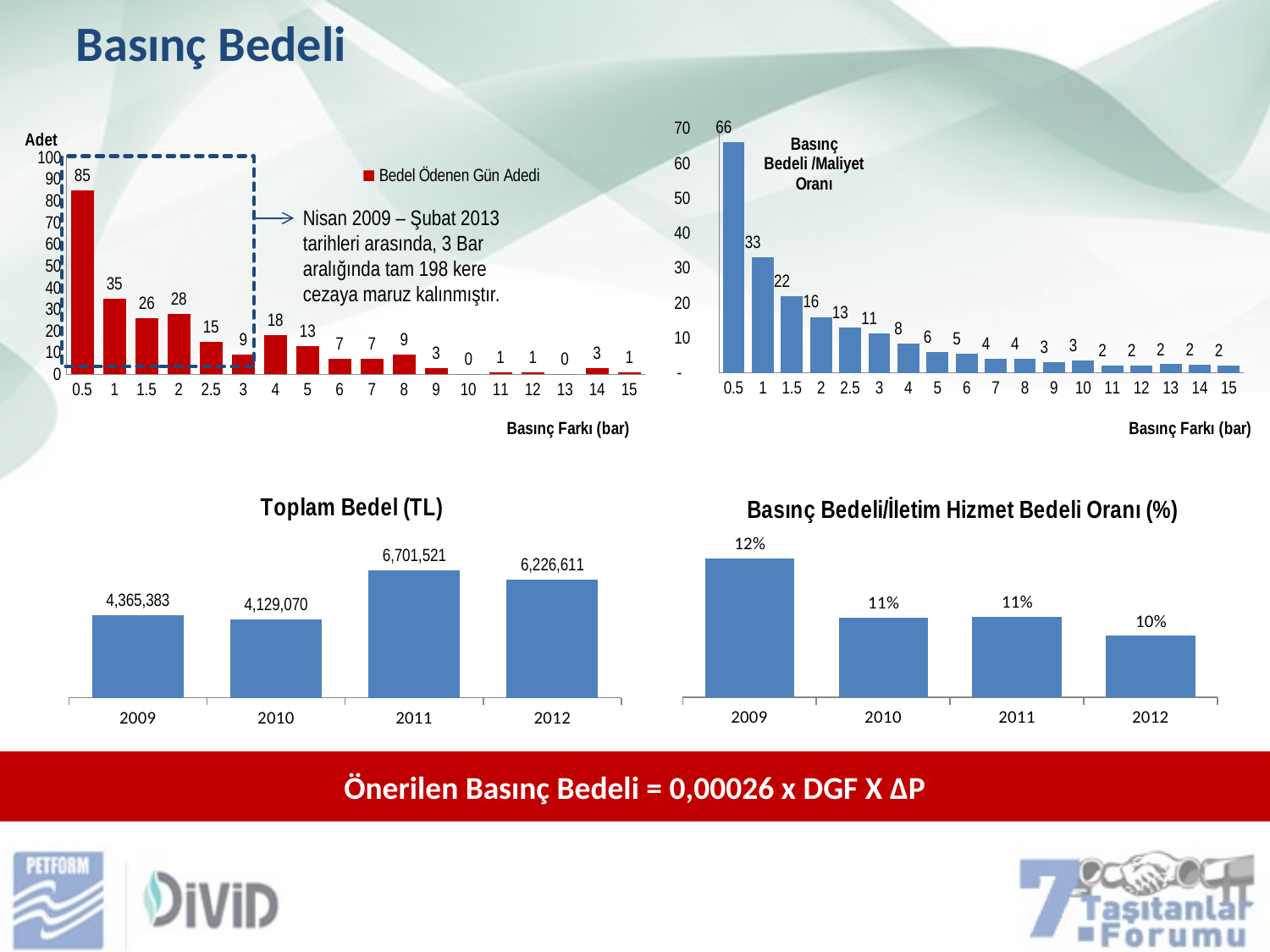
How many categories are shown on the x axis of the top-right 'Basınç Bedeli /Maliyet Oranı' chart? 18 In the top-right 'Basınç Bedeli /Maliyet Oranı' chart, what is the difference between the values at 0.5 bar and 1 bar? 33 In the top-left 'Bedel Ödenen Gün Adedi' chart, which is larger, the value at 1 bar or the value at 2 bar? 1 bar In the top-left 'Bedel Ödenen Gün Adedi' chart, what is the value at 0.5 bar? 85 In the 'Basınç Bedeli/İletim Hizmet Bedeli Oranı (%)' chart, do the values generally rise or fall from 2009 to 2012? fall In the top-left 'Bedel Ödenen Gün Adedi' chart, what is the value at 4 bar? 18 In the 'Toplam Bedel (TL)' chart, what is the difference between the values for 2011 and 2012? 474,910 In the 'Basınç Bedeli/İletim Hizmet Bedeli Oranı (%)' chart, which year has the highest value? 2009 In the top-right 'Basınç Bedeli /Maliyet Oranı' chart, what is the value at 1.5 bar? 22 In the 'Toplam Bedel (TL)' chart, which year has the lowest value? 2010 In the 'Basınç Bedeli/İletim Hizmet Bedeli Oranı (%)' chart, what is the value for 2012? 10% In the 'Toplam Bedel (TL)' chart, what is the value for 2011? 6,701,521